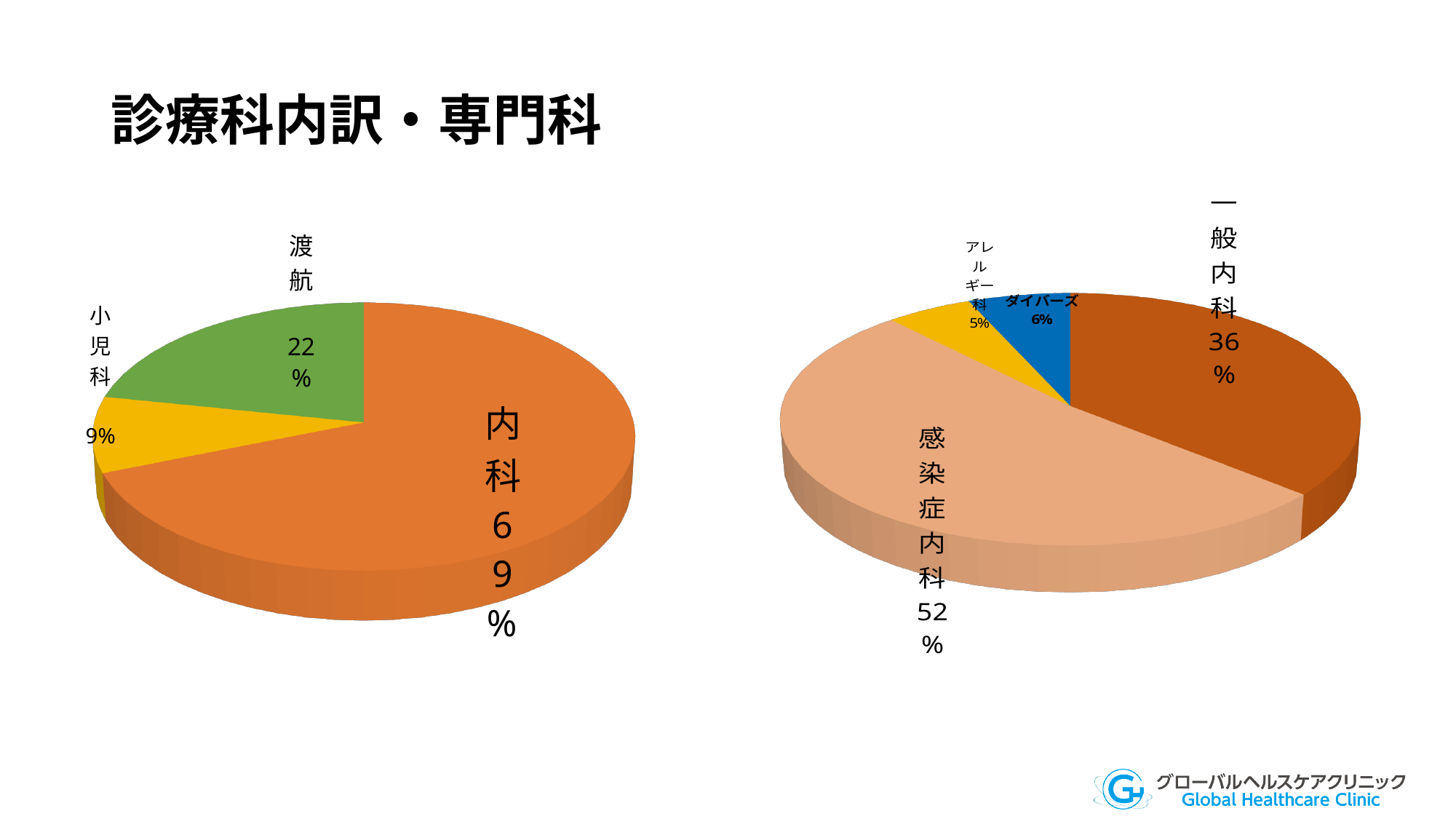
In the left pie chart, what share does 内科 have? 69% In the left pie chart, which category has the largest slice? 内科 In the left pie chart, what share does 小児科 have? 9% What kind of chart is shown on the right side of the slide? Pie chart In the right pie chart, what is the difference between the shares of 感染症内科 and 一般内科? 16% In the right pie chart, which category has the smallest slice? アレルギー科 In the left pie chart, what share does 渡航 have? 22% In the left pie chart, which category has the smallest slice? 小児科 In the right pie chart, what share does ダイバーズ have? 6% In the right pie chart, what share does 一般内科 have? 36% In the right pie chart, what share does 感染症内科 have? 52% In the left pie chart, how many slices are there? 3